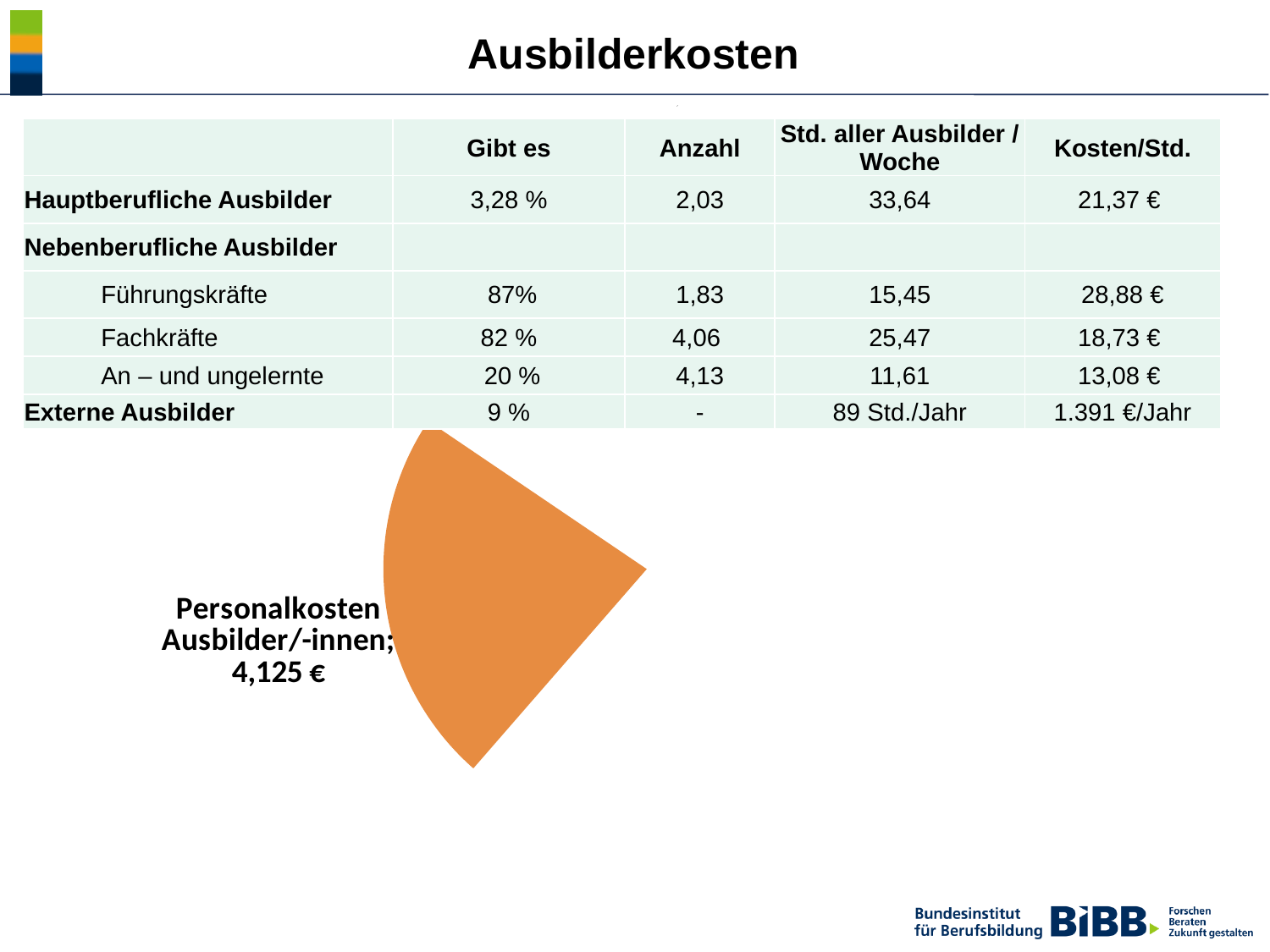
Which category does the labelled orange pie slice represent? Personalkosten Ausbilder/-innen What value is printed on the data label of the orange pie slice? 4,125 € What kind of chart is shown below the table on the slide? pie chart How many pie slices have a readable data label on the slide? 1 What colour is the visible slice of the pie chart? orange